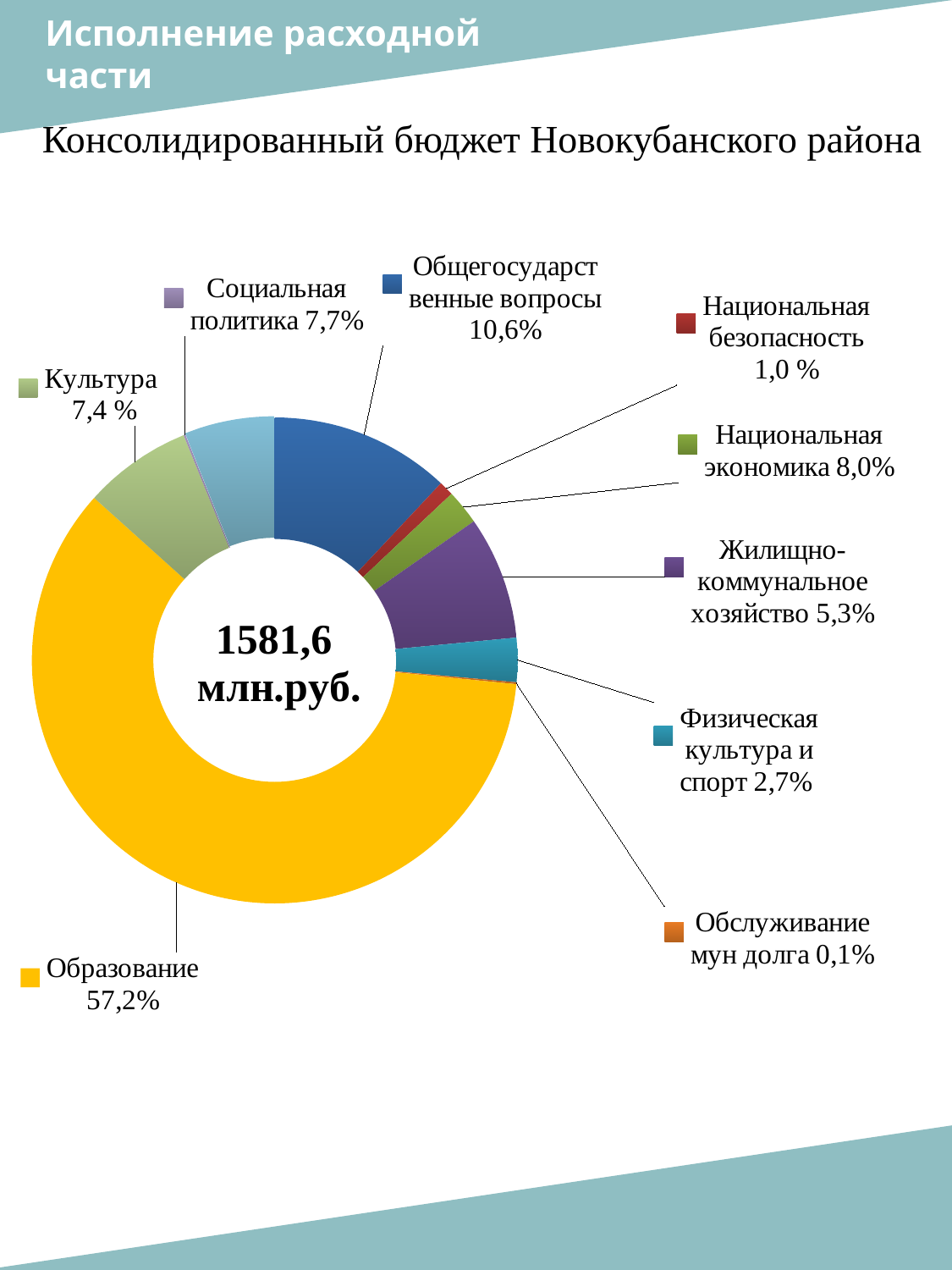
What is the value for Физическая культура и спорт? 2,7% How many categories are shown in the chart? 9 What percentage is shown for Жилищно-коммунальное хозяйство? 5,3% Which is larger, the share for Культура or the share for Жилищно-коммунальное хозяйство? Культура What is the value shown for Общегосударственные вопросы? 10,6% Which category has the largest share of the chart? Образование What kind of chart is shown on the slide? Doughnut (pie) chart What is the difference in percentage points between Национальная экономика and Социальная политика? 0,3 Which is larger, the share for Национальная безопасность or the share for Физическая культура и спорт? Физическая культура и спорт Which category has the smallest share of the chart? Обслуживание мун долга What total value is printed in the centre of the chart? 1581,6 млн.руб. What share of the chart does Образование account for? 57,2%